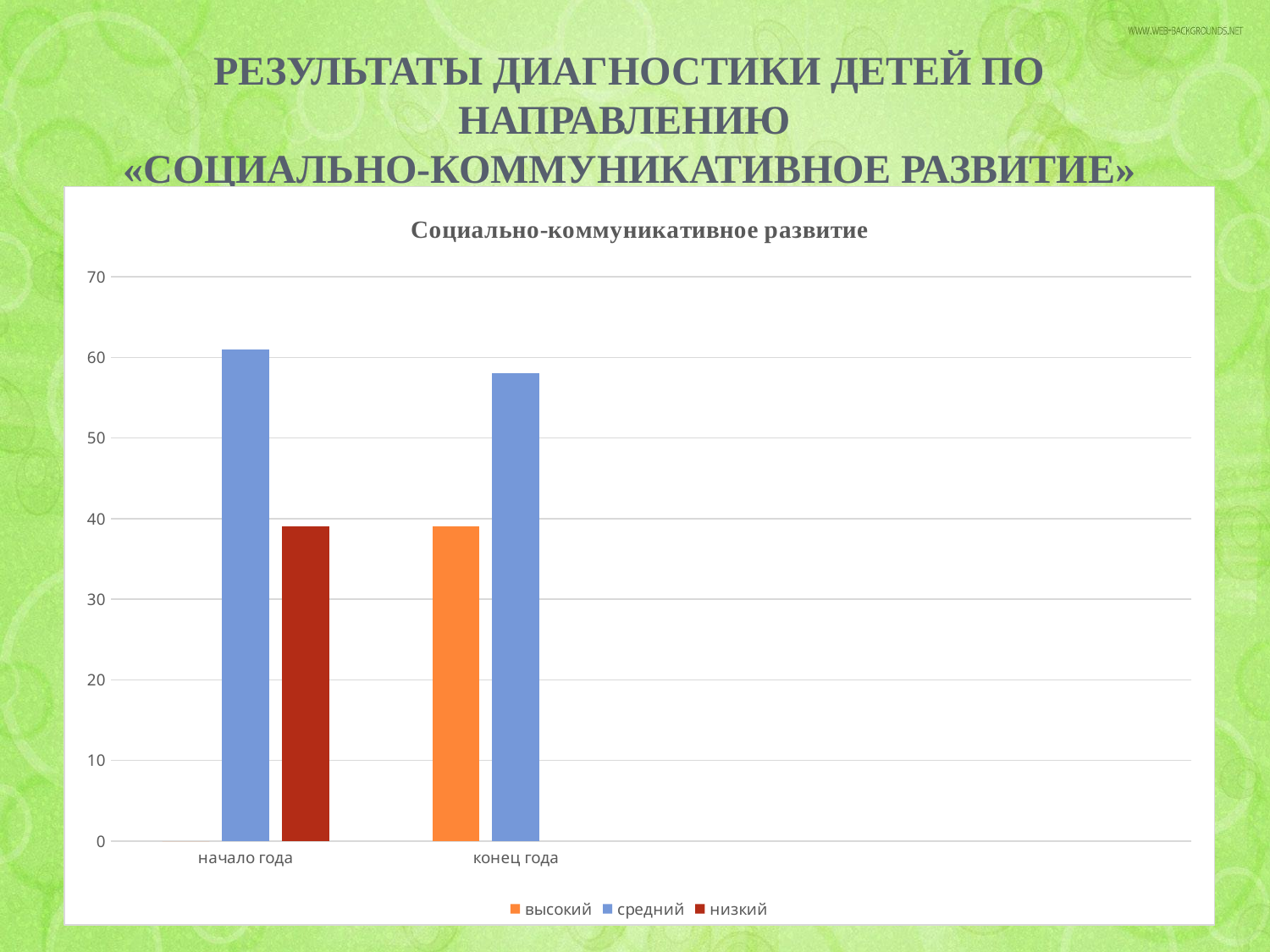
Which series has the tallest bar for конец года? средний Is the value for низкий at начало года greater or less than 30? greater Is the value for высокий at конец года greater or less than 30? greater Which series is shown in orange in the legend? высокий For начало года, which is larger: средний or низкий? средний Which series has the tallest bar for начало года? средний How many categories are shown on the x axis? 2 Is the value for средний at конец года greater or less than 50? greater How many series does the legend list? 3 What kind of chart is shown on the slide? bar chart What is the title of the chart? Социально-коммуникативное развитие